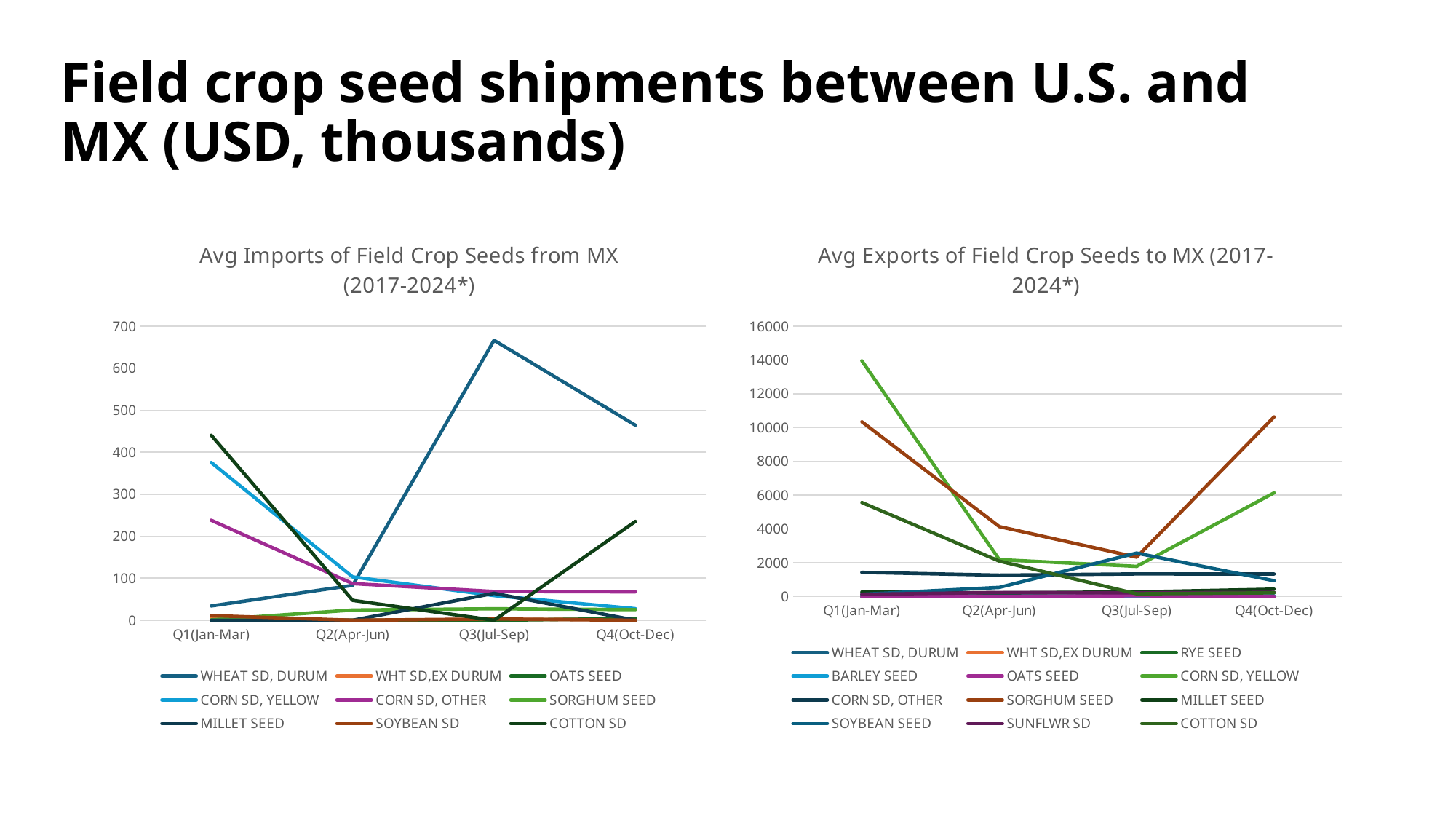
In the left chart (Avg Imports of Field Crop Seeds from MX), is the value for WHEAT SD, DURUM at Q3(Jul-Sep) greater or less than 600? greater What kind of chart is the 'Avg Imports of Field Crop Seeds from MX (2017-2024*)' chart on the left? Line chart In the right chart (Avg Exports of Field Crop Seeds to MX), which is larger at Q4(Oct-Dec): SORGHUM SEED or CORN SD, YELLOW? SORGHUM SEED In the right chart (Avg Exports of Field Crop Seeds to MX), does the CORN SD, YELLOW line rise or fall from Q1(Jan-Mar) to Q3(Jul-Sep)? Fall In the right chart (Avg Exports of Field Crop Seeds to MX), which series has the highest value at Q1(Jan-Mar)? CORN SD, YELLOW In the left chart (Avg Imports of Field Crop Seeds from MX), is the value for CORN SD, YELLOW at Q1(Jan-Mar) greater or less than 300? greater How many series does the legend of the left chart (Avg Imports of Field Crop Seeds from MX) list? 9 What is the title of the chart on the left side of the slide? Avg Imports of Field Crop Seeds from MX (2017-2024*) How many series does the legend of the right chart (Avg Exports of Field Crop Seeds to MX) list? 12 How many quarters are shown on the x axis of the right chart (Avg Exports of Field Crop Seeds to MX)? 4 In the left chart (Avg Imports of Field Crop Seeds from MX), which series has the highest value at Q3(Jul-Sep)? WHEAT SD, DURUM In the right chart (Avg Exports of Field Crop Seeds to MX), is the value for CORN SD, YELLOW at Q1(Jan-Mar) greater or less than 12000? greater